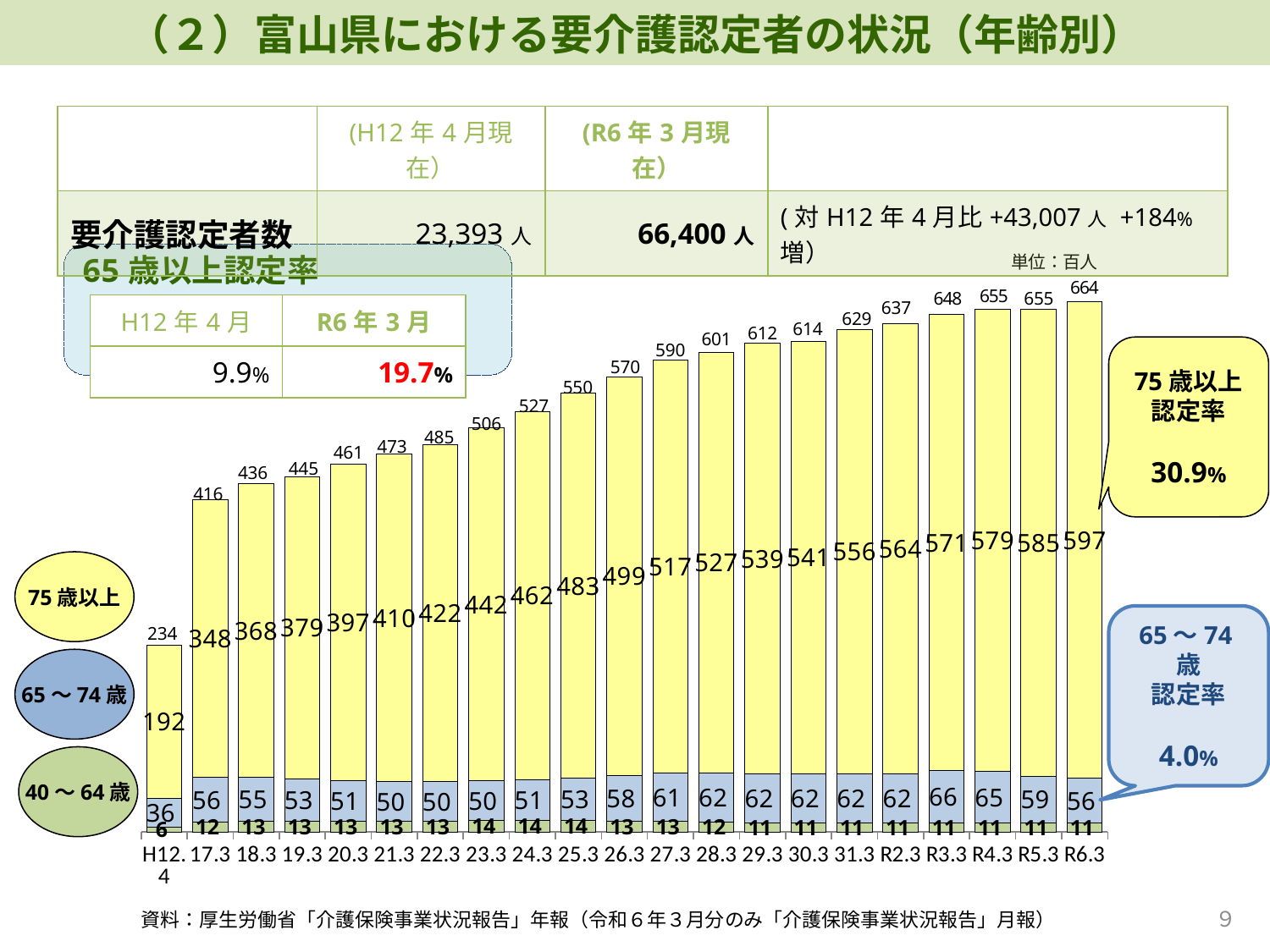
棒の合計値が最も小さいのはどの時点ですか？ H12.4 グラフの凡例には何種類の年齢区分がありますか？ 3 R3.3の棒の合計値はいくつですか？ 648 棒の合計値は横軸に沿って全体として増加していますか、減少していますか？ 増加 グラフの単位は何ですか？ 百人 R6.3とH12.4の合計値の差はいくつですか？ 430 棒の合計値が最も大きいのはどの時点ですか？ R6.3 R6.3の75歳以上の値はいくつですか？ 597 65〜74歳の値は、R3.3と25.3ではどちらが大きいですか？ R3.3 H12.4の65〜74歳の値はいくつですか？ 36 このグラフはどの種類のグラフですか？ 積み上げ棒グラフ グラフには何本の棒（時点）がありますか？ 21